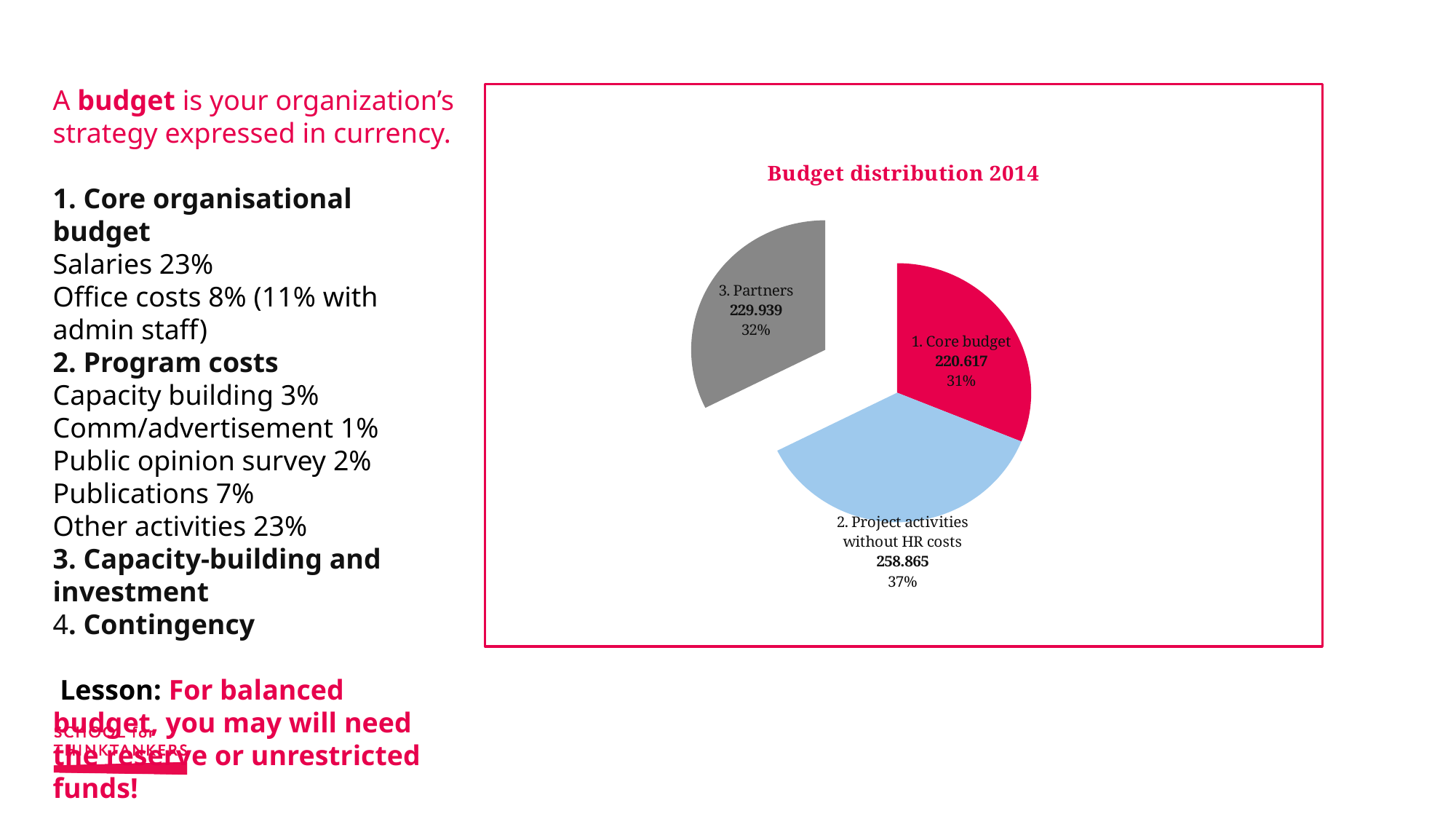
What percentage share does '1. Core budget' have in the Budget distribution 2014 chart? 31% What is the title of the chart on the slide? Budget distribution 2014 What is the value shown for '2. Project activities without HR costs' in the pie chart? 258.865 What is the value shown for the '1. Core budget' slice in the Budget distribution 2014 pie chart? 220.617 How many slices does the Budget distribution 2014 pie chart have? 3 What colour is the '3. Partners' slice in the pie chart? Grey Which slice of the Budget distribution 2014 pie chart is the largest? 2. Project activities without HR costs Which is larger in the Budget distribution 2014 chart: '3. Partners' or '1. Core budget'? 3. Partners What type of chart is used to show the Budget distribution 2014? Pie chart Which slice of the Budget distribution 2014 pie chart is the smallest? 1. Core budget What is the difference between the values for '2. Project activities without HR costs' and '1. Core budget' in the pie chart? 38.248 What percentage of the Budget distribution 2014 pie does '3. Partners' represent? 32%